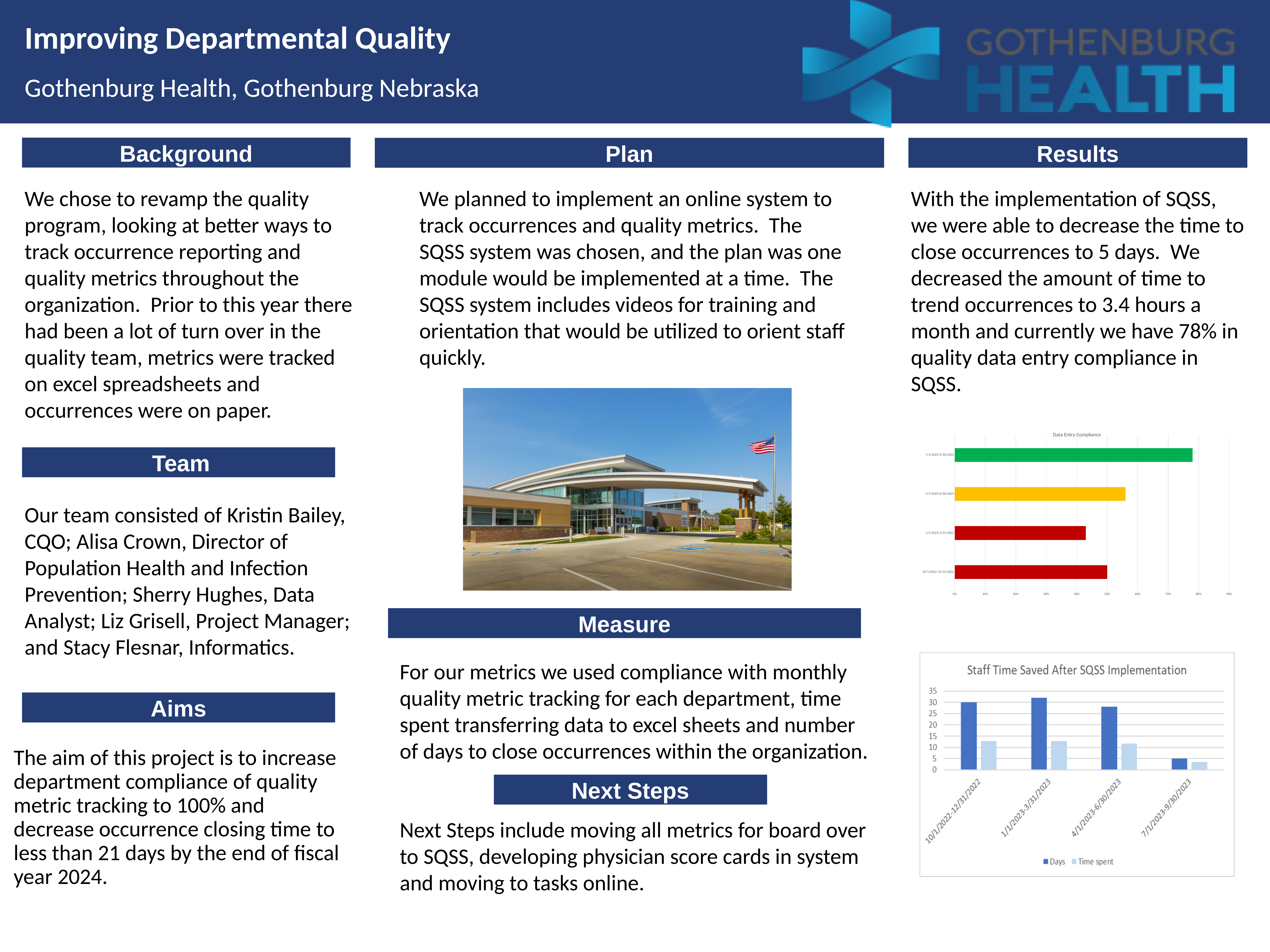
In the 'Staff Time Saved After SQSS Implementation' chart, which period has the lowest value for Days? 7/1/2023-9/30/2023 In the 'Staff Time Saved After SQSS Implementation' chart, is the Days value for 7/1/2023-9/30/2023 greater or less than 10? less In the 'Data Entry Compliance' chart, which period has the lowest compliance? 1/1/2023-3/31/2023 In the 'Data Entry Compliance' chart, is the value for 1/1/2023-3/31/2023 greater or less than 50%? less In the 'Staff Time Saved After SQSS Implementation' chart, for 4/1/2023-6/30/2023, which is larger: Days or Time spent? Days In the 'Data Entry Compliance' chart, which period has the highest compliance? 7/1/2023-9/30/2023 What kind of chart is the 'Data Entry Compliance' chart? bar chart What kind of chart is 'Staff Time Saved After SQSS Implementation'? bar chart In the 'Staff Time Saved After SQSS Implementation' chart, is the Days value for 10/1/2022-12/31/2022 greater or less than 25? greater How many series does the legend of the 'Staff Time Saved After SQSS Implementation' chart list? 2 How many categories are shown in the 'Data Entry Compliance' chart? 4